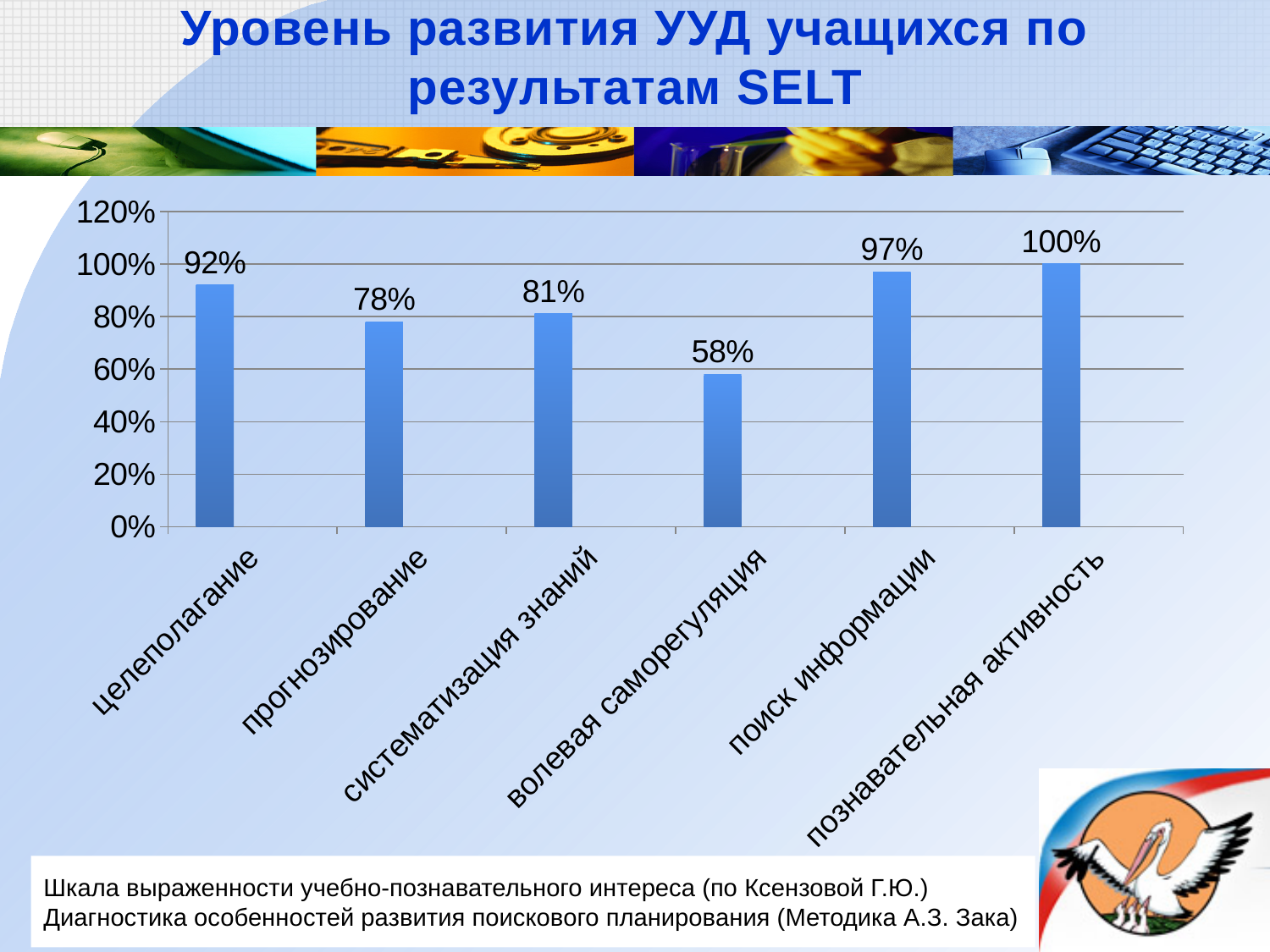
What kind of chart is shown on the slide? bar chart Which category has the lowest value? волевая саморегуляция What is the difference between the values for познавательная активность and волевая саморегуляция? 42% Which is larger, the value for систематизация знаний or the value for прогнозирование? систематизация знаний Which category has the highest value? познавательная активность What is the value for поиск информации? 97% What is the value for целеполагание? 92% What is the value for волевая саморегуляция? 58% How many categories are shown on the chart? 6 Is the value for волевая саморегуляция greater or less than 60%? less What is the difference between the values for целеполагание and прогнозирование? 14% What is the highest value shown on the vertical axis? 120%